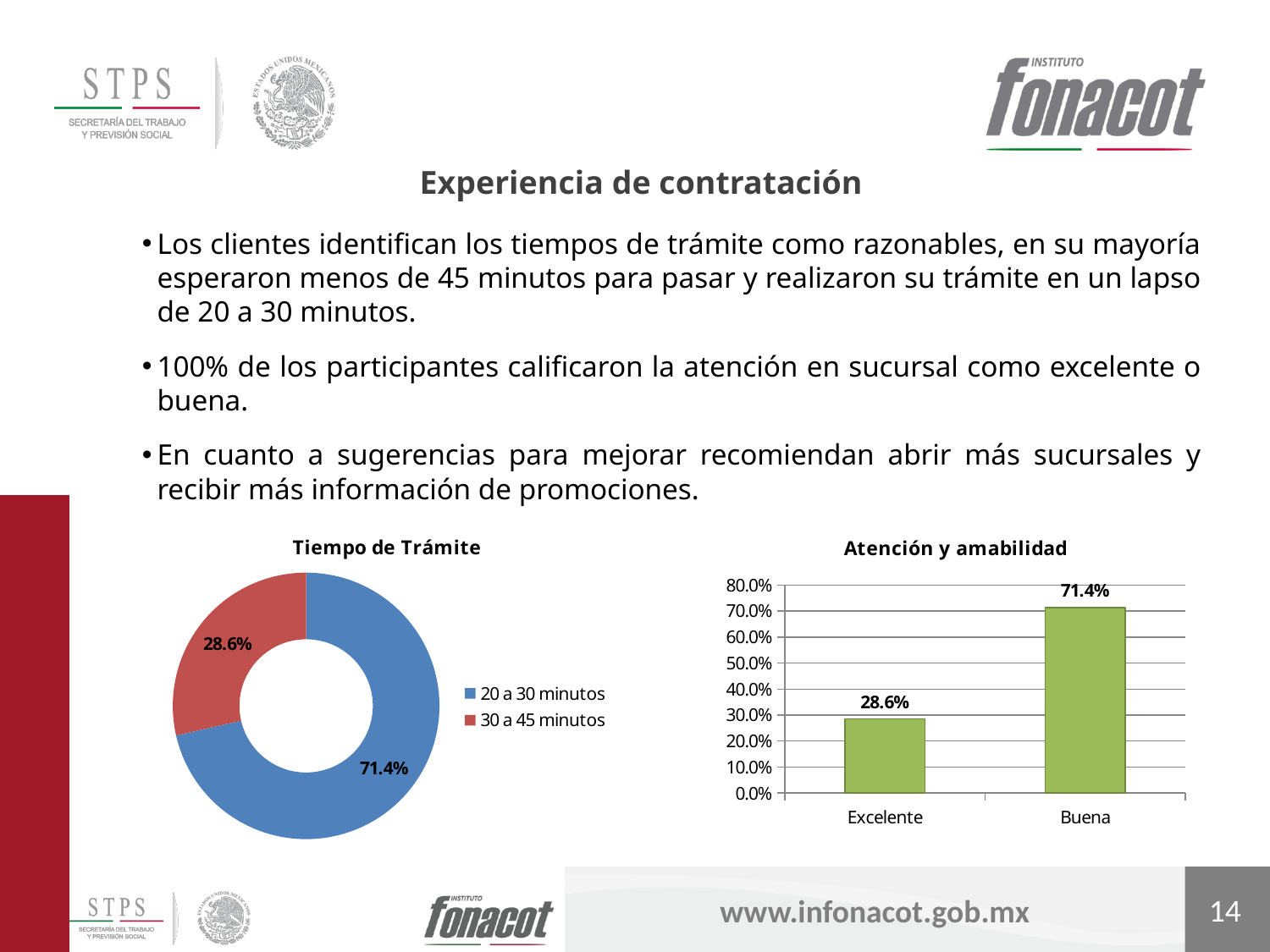
How many categories does the legend of the 'Tiempo de Trámite' chart list? 2 In the 'Atención y amabilidad' chart, what is the value for Buena? 71.4% How many categories are shown on the x axis of the 'Atención y amabilidad' chart? 2 In the 'Tiempo de Trámite' chart, which category has the largest share? 20 a 30 minutos In the 'Atención y amabilidad' chart, what is the difference between Buena and Excelente? 42.8% In the 'Tiempo de Trámite' chart, what share of clients took 30 a 45 minutos? 28.6% In the 'Tiempo de Trámite' chart, what share of clients took 20 a 30 minutos? 71.4% In the 'Atención y amabilidad' chart, which category has the highest value? Buena In the 'Atención y amabilidad' chart, is the value for Excelente greater or less than 30.0%? less In the 'Atención y amabilidad' chart, what is the value for Excelente? 28.6% What kind of chart is 'Tiempo de Trámite'? Doughnut (pie) chart What kind of chart is 'Atención y amabilidad'? Bar chart